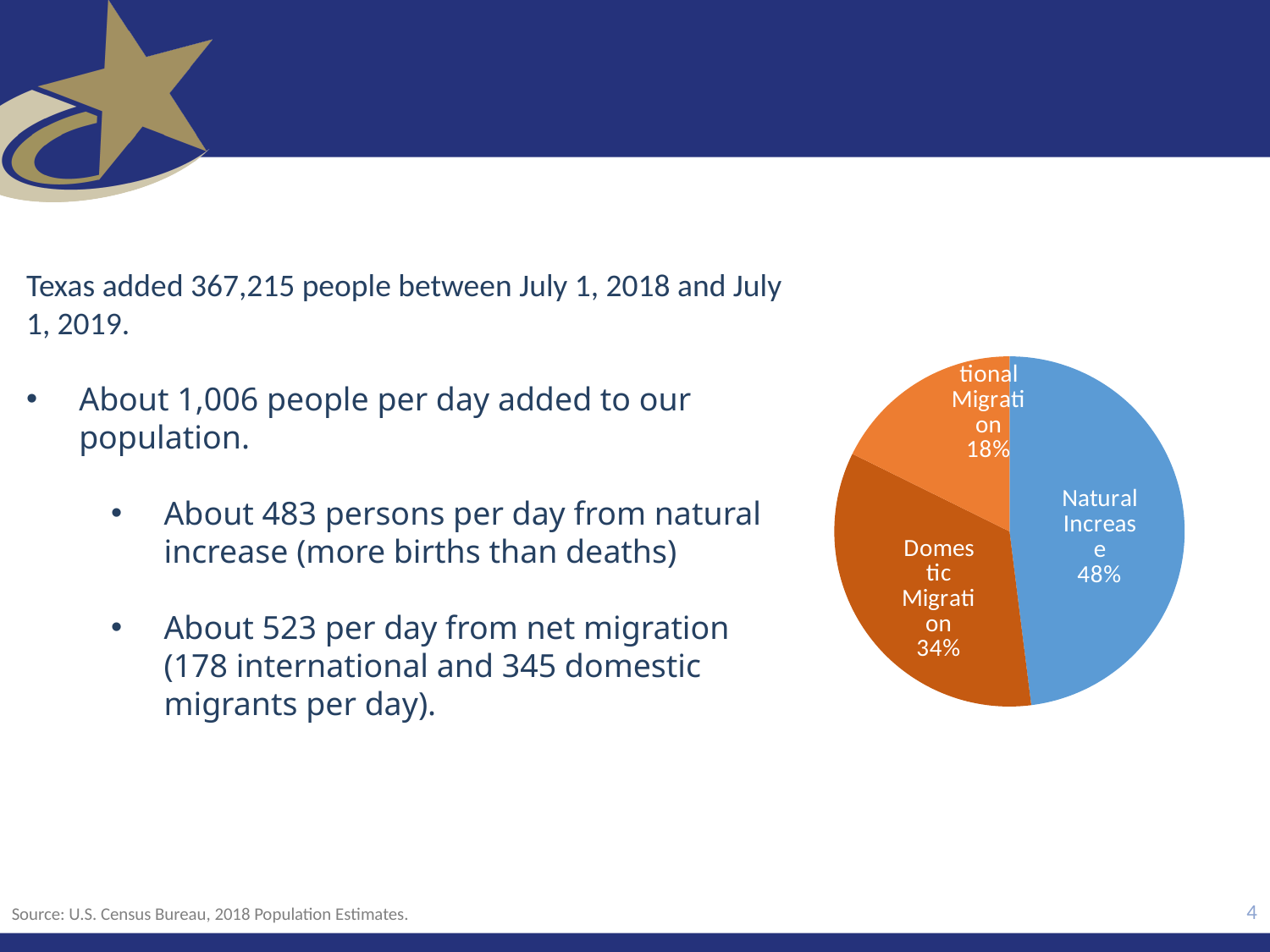
Which is larger, the Domestic Migration slice or the International Migration slice? Domestic Migration Which slice of the pie chart is the smallest? International Migration What share of the pie does Natural Increase account for? 48% What share of the pie does International Migration account for? 18% What colour is the Natural Increase slice in the pie chart? blue How many percentage points larger is the Natural Increase slice than the Domestic Migration slice? 14 percentage points What kind of chart is shown on the slide? pie chart How many slices does the pie chart have? 3 Which slice of the pie chart is the largest? Natural Increase Is the share for Natural Increase greater or less than 50%? less What share of the pie does Domestic Migration account for? 34% What is the combined share of the Domestic Migration and International Migration slices? 52%